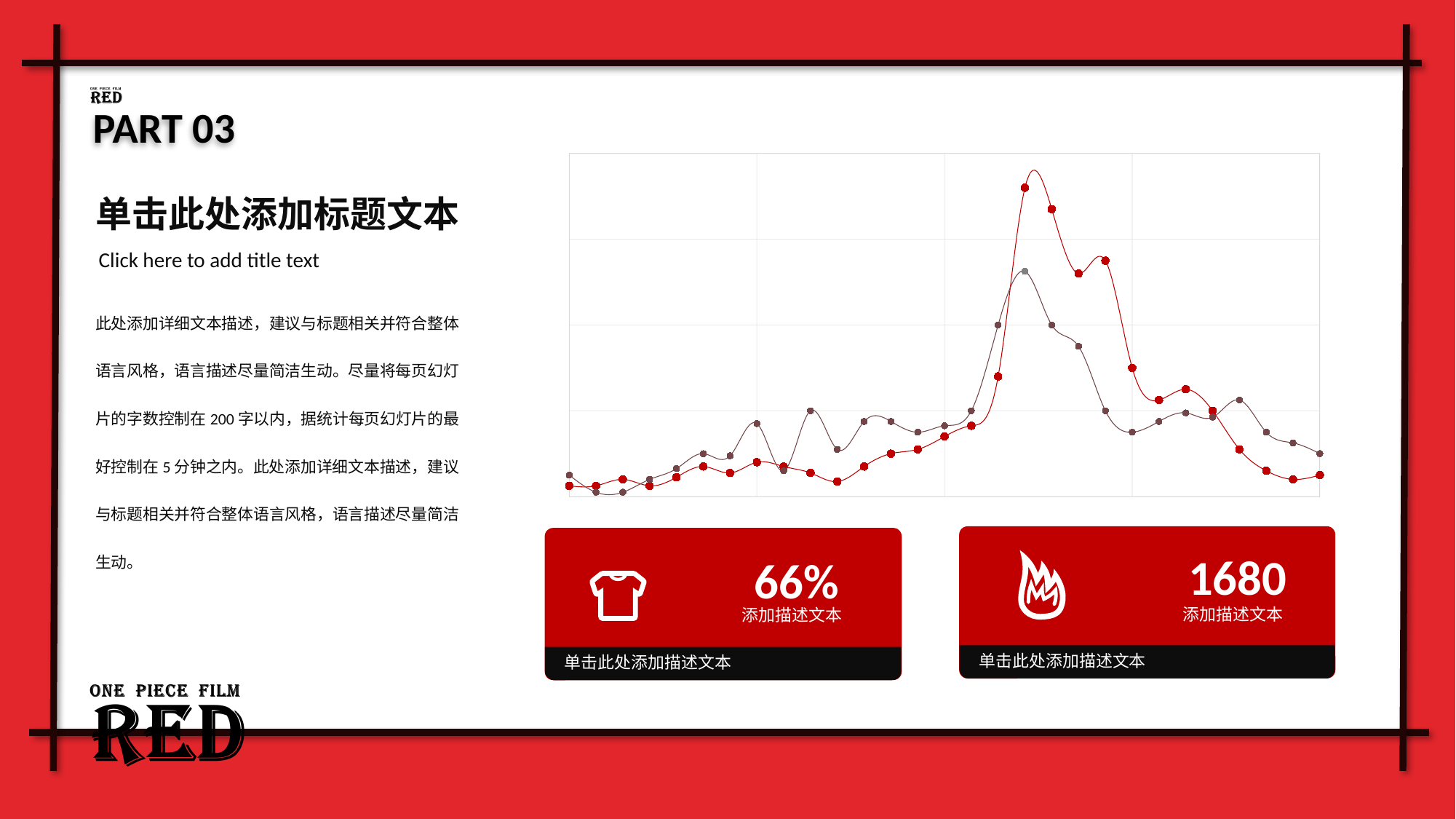
Does the chart display a legend? No Does the red line rise or fall from its highest peak toward the right end of the chart? fall In the left part of the chart, before the large peak, is the dark grey line generally above or below the red line? above What colours are the two lines on the chart? red and dark grey How many lines are plotted on the chart? 2 What kind of chart is shown on the slide? line chart Which line reaches the highest peak on the chart, the red line or the dark grey line? the red line